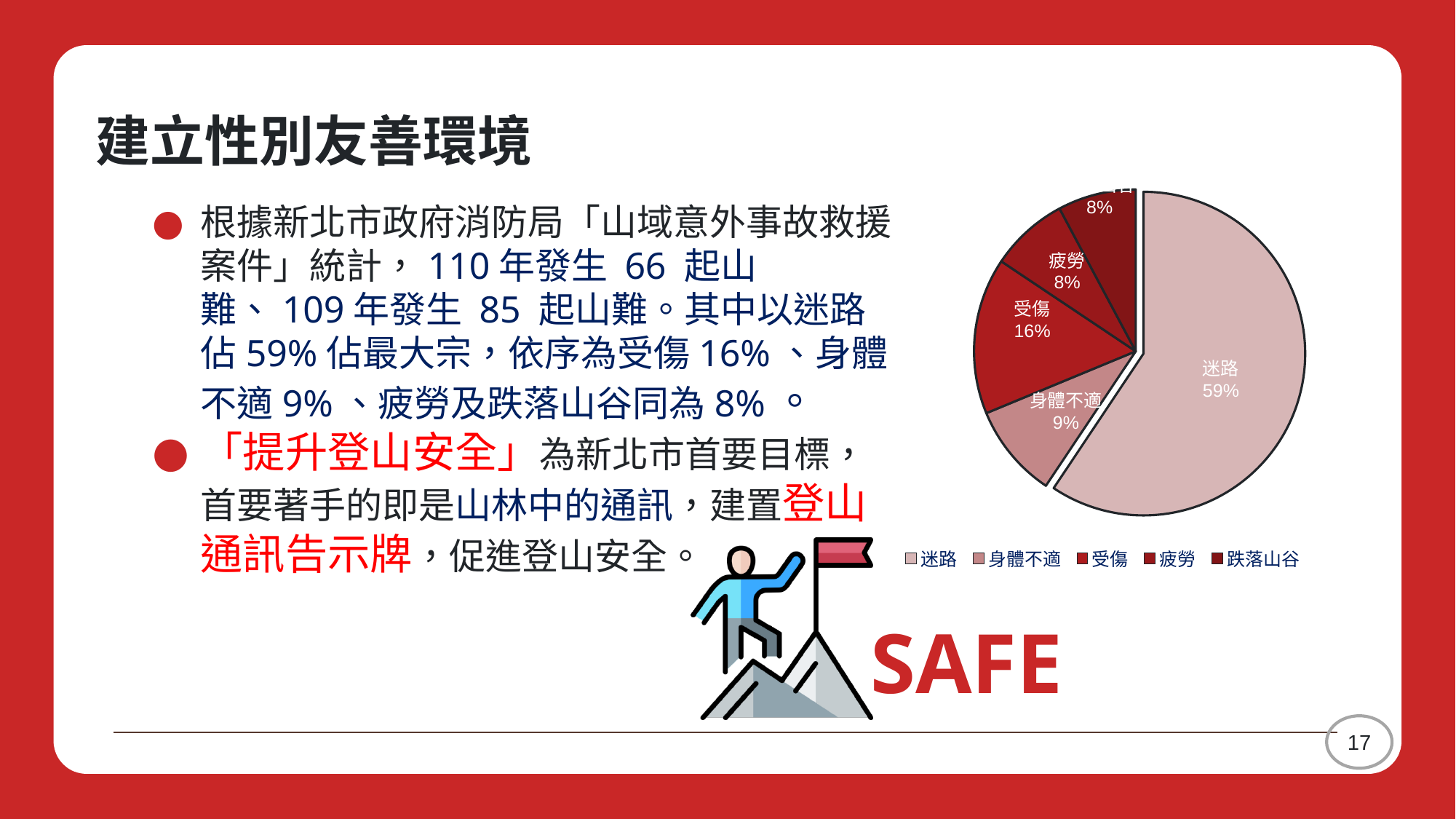
What share of the pie does 迷路 account for? 59% What share of the pie does 身體不適 account for? 9% How many categories does the legend of the pie chart list? 5 Which category is listed last in the legend of the pie chart? 跌落山谷 Which category is listed first in the legend of the pie chart? 迷路 What share of the pie does 受傷 account for? 16% What is the difference in percentage points between 迷路 and 受傷? 43 Which is larger, the slice for 受傷 or the slice for 身體不適? 受傷 What share of the pie does 疲勞 account for? 8% What is the difference in percentage points between 受傷 and 疲勞? 8 Which category has the largest slice of the pie? 迷路 What kind of chart is shown on the slide? pie chart